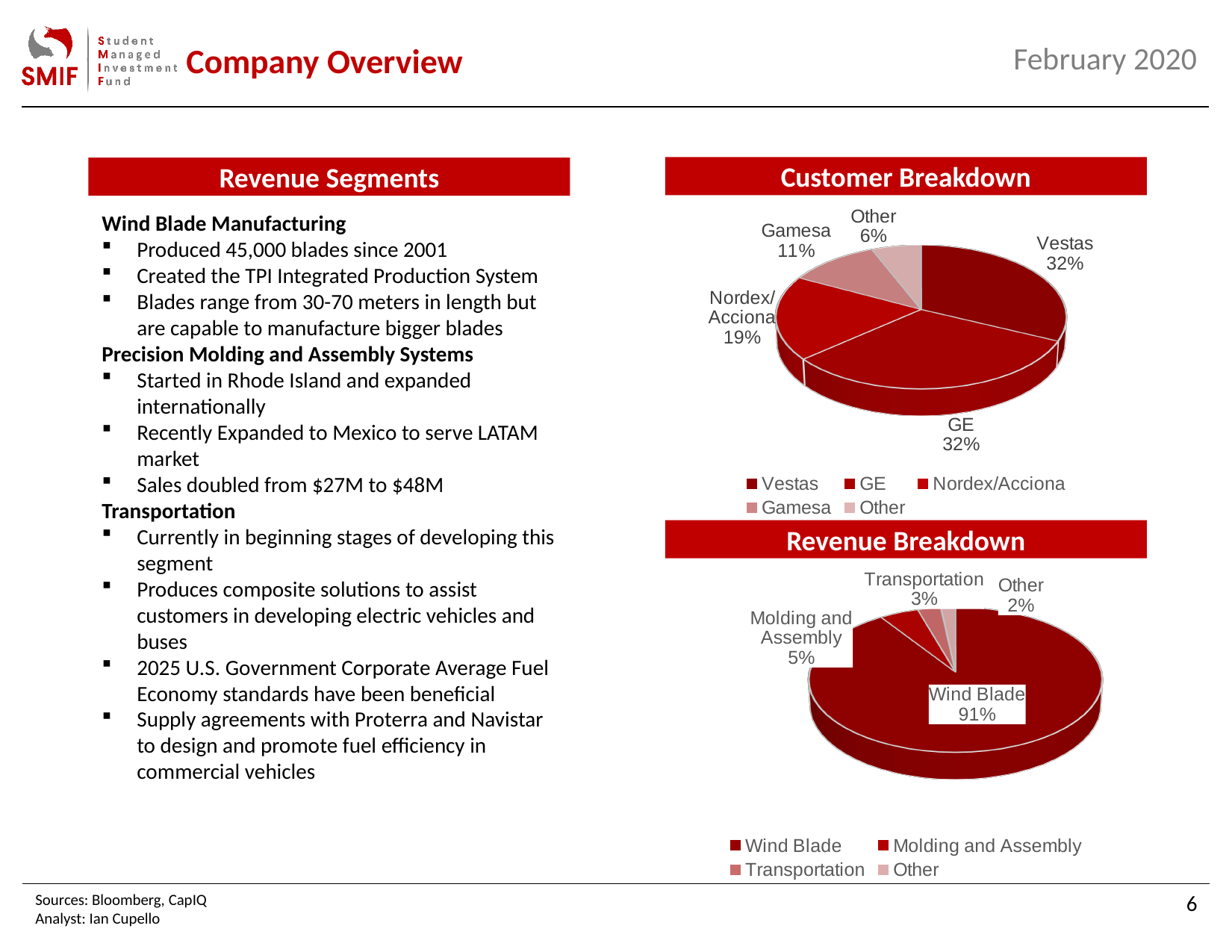
In the Customer Breakdown chart, which customer has the smallest share? Other In the Customer Breakdown chart, what share of customers is Nordex/Acciona? 19% In the Customer Breakdown chart, how many slices does the pie have? 5 How many entries does the legend of the Revenue Breakdown chart list? 4 In the Revenue Breakdown chart, which segment has the largest share? Wind Blade In the Revenue Breakdown chart, what share of revenue comes from Transportation? 3% In the Revenue Breakdown chart, what share of revenue comes from Wind Blade? 91% In the Customer Breakdown chart, what is the difference between the Vestas share and the Gamesa share? 21% In the Customer Breakdown chart, what share does Gamesa represent? 11% In the Customer Breakdown chart, which is larger, the Nordex/Acciona share or the Gamesa share? Nordex/Acciona What type of chart is the Revenue Breakdown chart? Pie chart In the Revenue Breakdown chart, which segment has the smallest share? Other